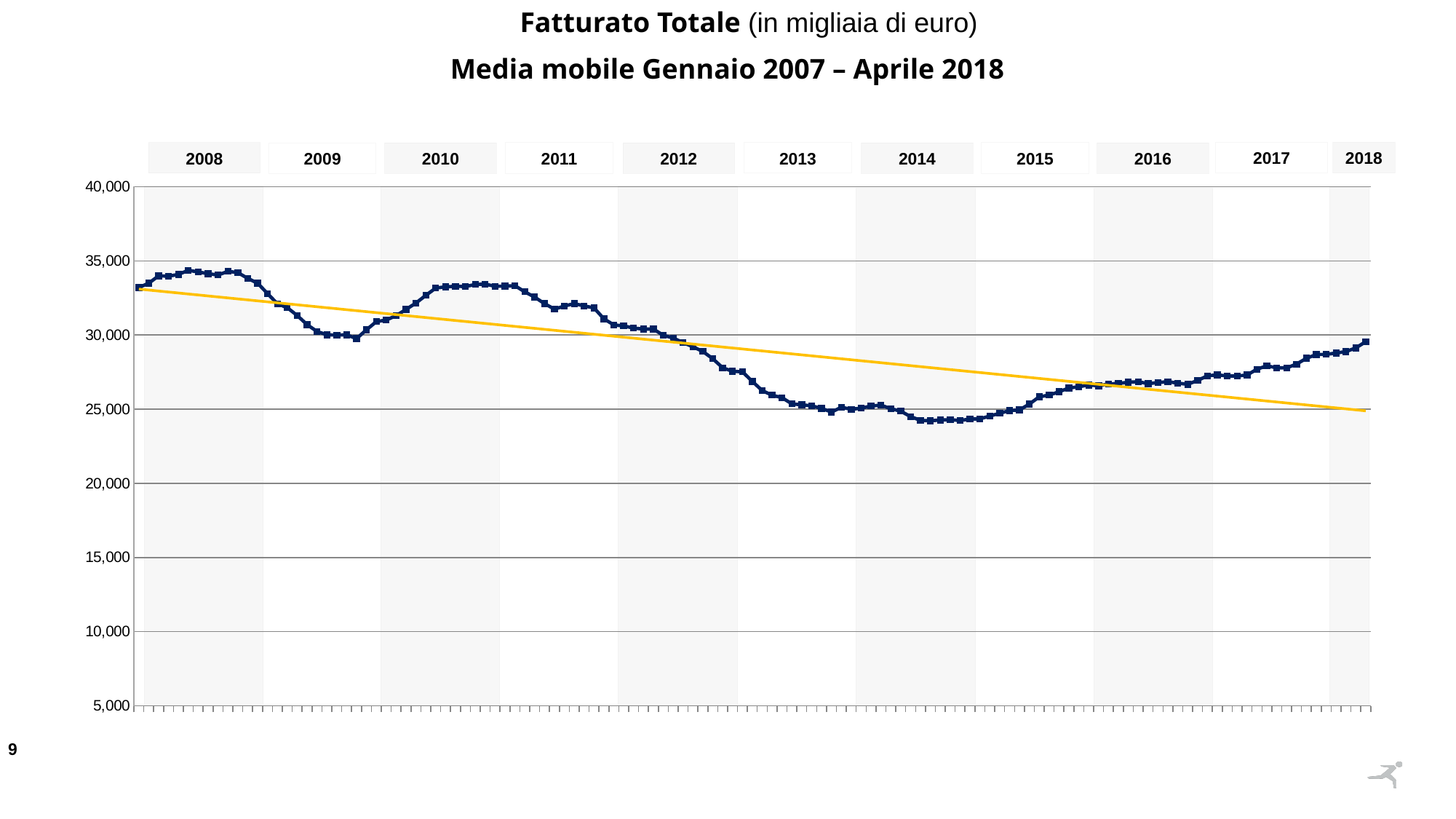
Is the moving average value in the middle of 2010 greater or less than 30,000? greater Is the moving average value at the end of the series in 2018 greater or less than 25,000? greater What kind of chart is shown on the slide? line chart Does the yellow trend line rise or fall from left to right? fall Is the moving average value in the middle of 2014 greater or less than 25,000? less How many year labels are shown along the top of the chart? 11 What is the last year label shown on the chart? 2018 Does the blue moving average line rise or fall between 2014 and 2018? rise What is the highest value shown on the vertical axis? 40,000 What is the title of the chart? Fatturato Totale (in migliaia di euro) – Media mobile Gennaio 2007 – Aprile 2018 What is the first year label shown on the chart? 2008